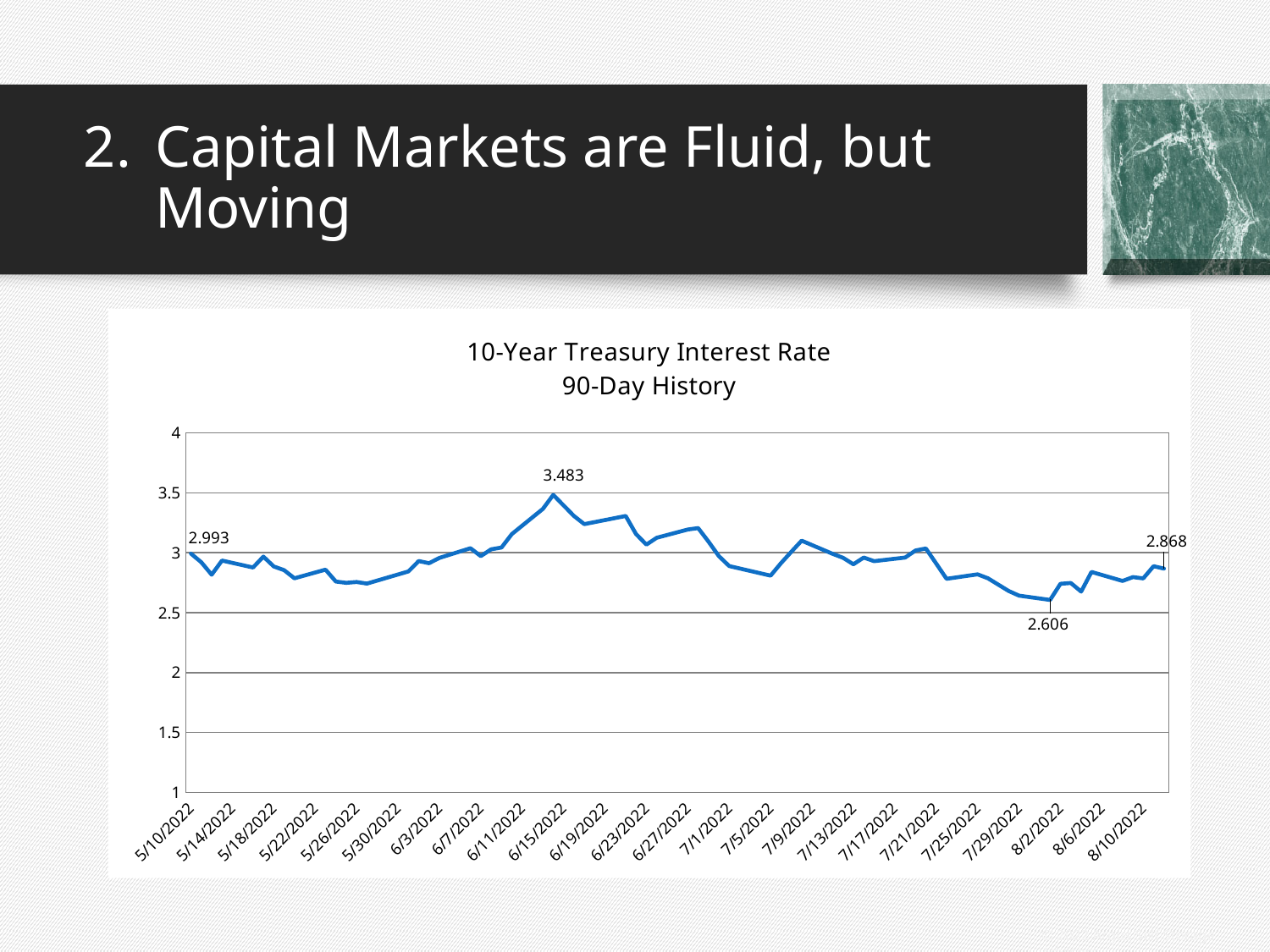
What is the maximum value shown on the vertical axis? 4 Does the interest rate rise or fall between 5/26/2022 and 6/15/2022? rise What is the title of the chart? 10-Year Treasury Interest Rate 90-Day History What is the highest value labeled on the line? 3.483 What is the value labeled at the final data point of the line? 2.868 What is the value of the first data point, on 5/10/2022? 2.993 What kind of chart is shown on the slide? line chart Is the value around 7/29/2022 greater or less than 3? less Which is larger, the value at the start of the series (5/10/2022) or the peak value in mid-June? the peak value in mid-June What is the lowest value labeled on the line? 2.606 What is the difference between the highest labeled value (3.483) and the lowest labeled value (2.606)? 0.877 What is the difference between the first labeled value (2.993) and the last labeled value (2.868)? 0.125